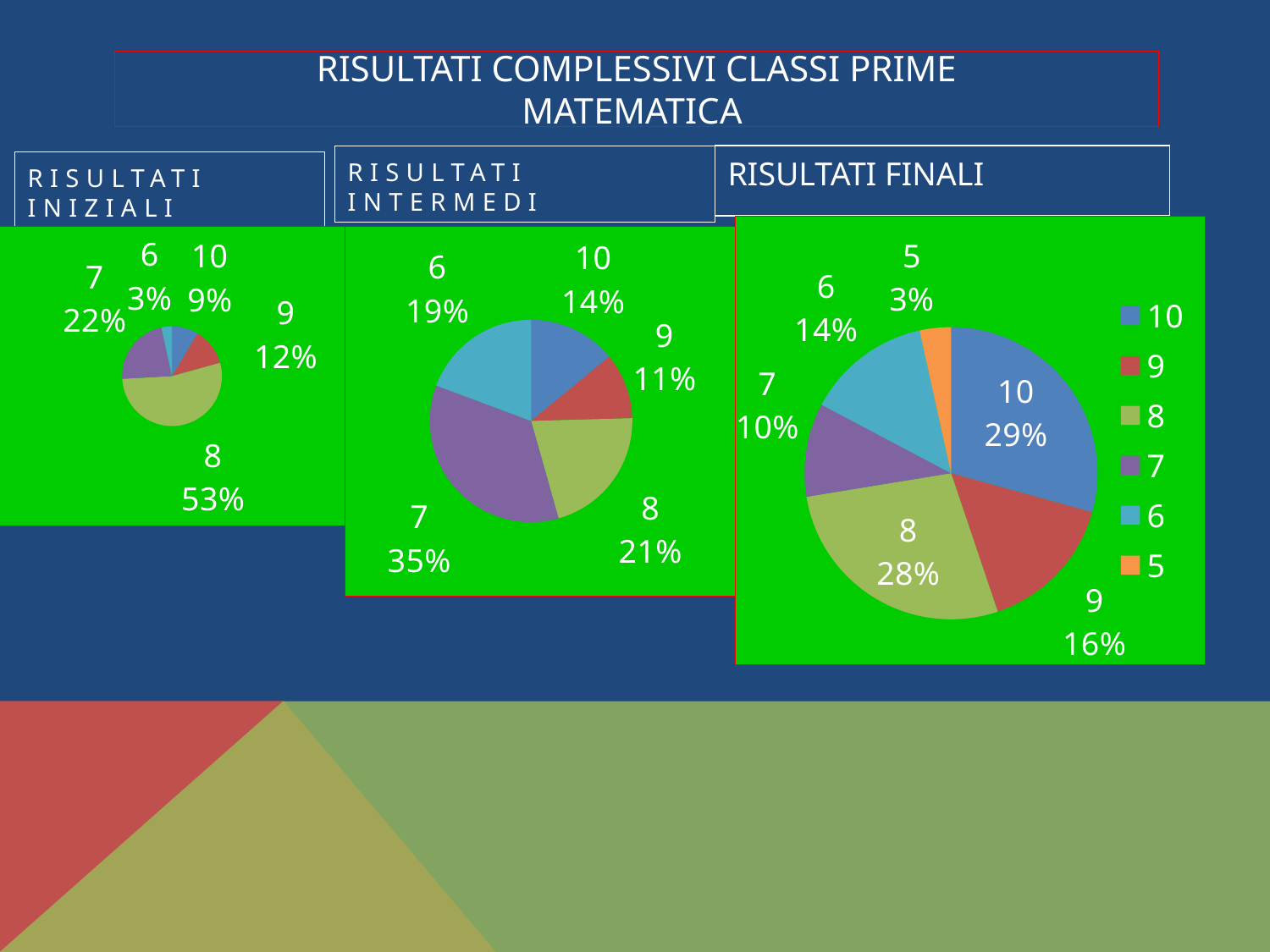
What kind of chart is the RISULTATI FINALI chart? pie chart In the RISULTATI FINALI chart, what share does grade 10 have? 29% How many entries does the legend of the RISULTATI FINALI chart list? 6 In the RISULTATI FINALI chart, what is the difference between the shares of grade 10 and grade 9? 13% How many slices does the RISULTATI INIZIALI chart have? 5 In the RISULTATI INIZIALI chart, what share does grade 8 have? 53% In the RISULTATI INTERMEDI chart, what is the difference between the shares of grade 8 and grade 9? 10% In the RISULTATI INIZIALI chart, which grade has the smallest share? 6 In the RISULTATI INTERMEDI chart, which grade has the largest share? 7 In the RISULTATI FINALI chart, which is larger, the share of grade 6 or the share of grade 7? grade 6 In the RISULTATI FINALI chart, which grade has the smallest share? 5 In the RISULTATI INTERMEDI chart, what share does grade 7 have? 35%